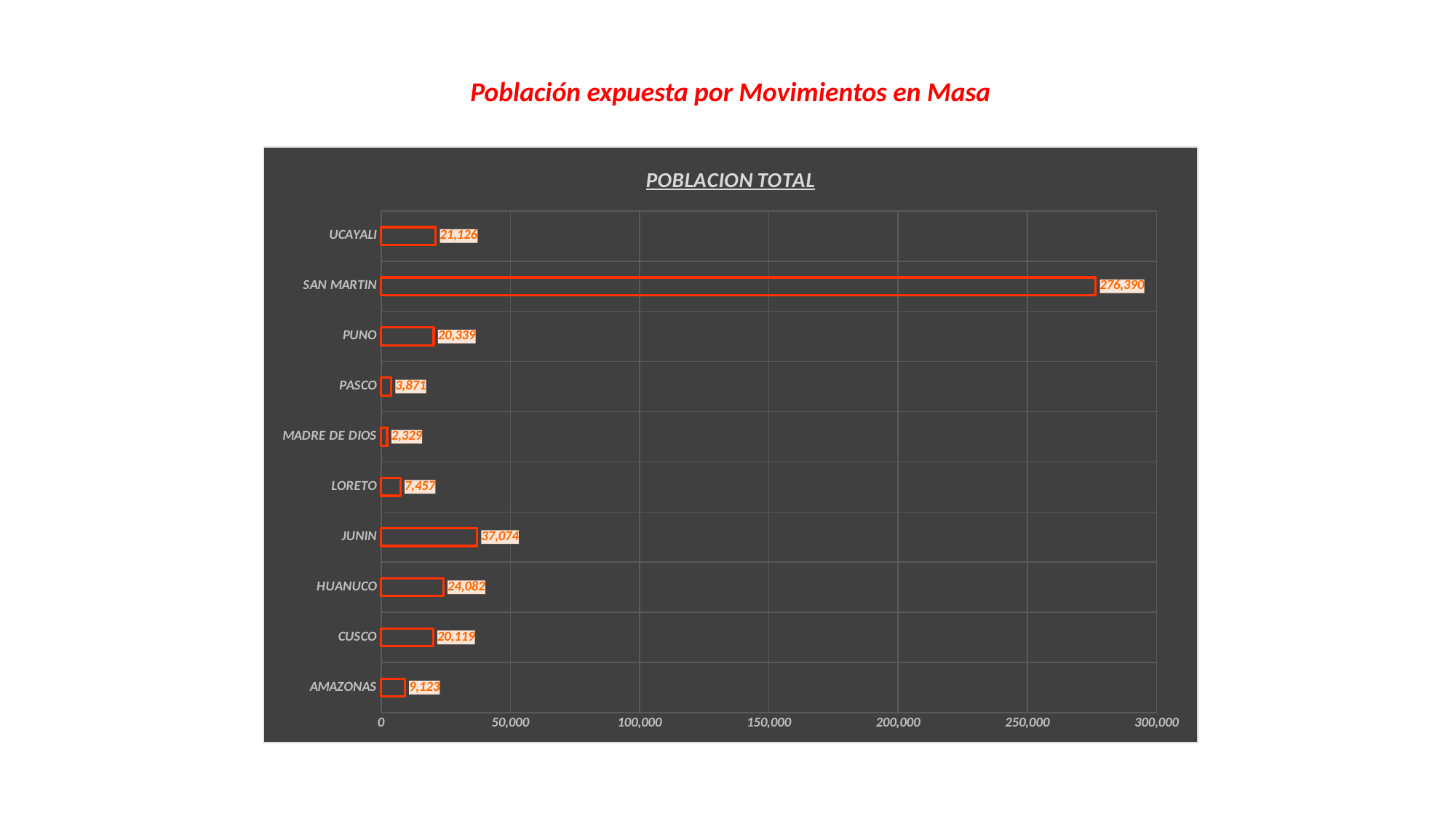
How many categories are shown in the chart? 10 What kind of chart is shown? bar chart Is the value for SAN MARTIN greater or less than 250,000? greater What is the difference between the values for JUNIN and HUANUCO? 12,992 What is the value for MADRE DE DIOS? 2,329 Which is larger, the value for UCAYALI or the value for PUNO? UCAYALI Which category has the lowest value? MADRE DE DIOS What is the title of the chart? POBLACION TOTAL Which category has the highest value? SAN MARTIN What is the value for JUNIN? 37,074 What is the value for SAN MARTIN? 276,390 What is the value for AMAZONAS? 9,123